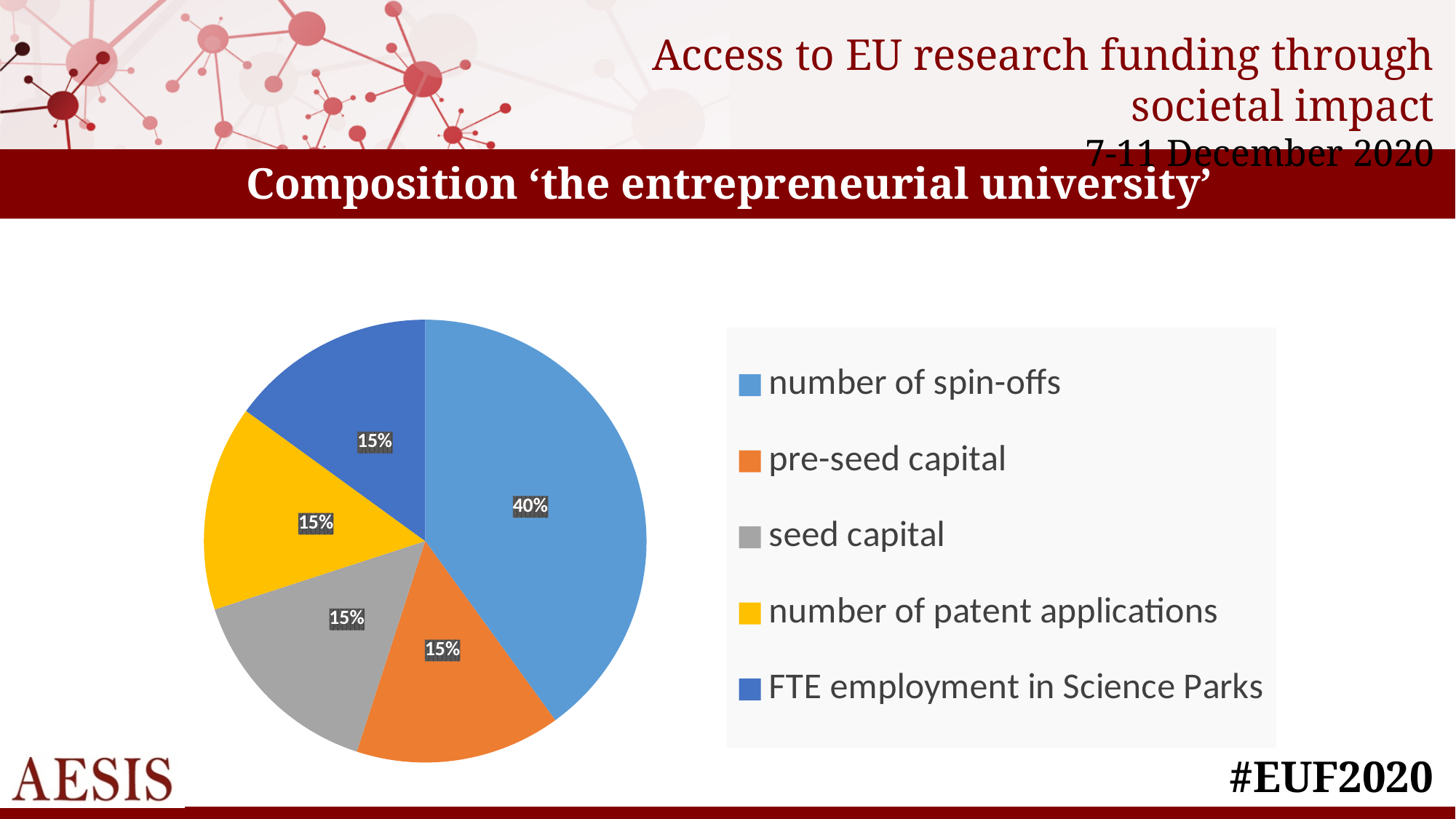
Which is larger, the slice for 'number of spin-offs' or the slice for 'pre-seed capital'? number of spin-offs What is the difference between the share for 'number of spin-offs' and the share for 'seed capital'? 25% What share of the pie does 'number of spin-offs' take? 40% How many entries does the legend list? 5 What kind of chart is shown on the slide? pie chart What is the title of the chart section on the slide? Composition 'the entrepreneurial university' What is the value shown for 'number of patent applications'? 15% What is the value shown for 'pre-seed capital'? 15% What is the value shown for 'FTE employment in Science Parks'? 15% Which category has the largest slice of the pie? number of spin-offs How many slices does the pie chart have? 5 Which legend entry is shown in orange? pre-seed capital